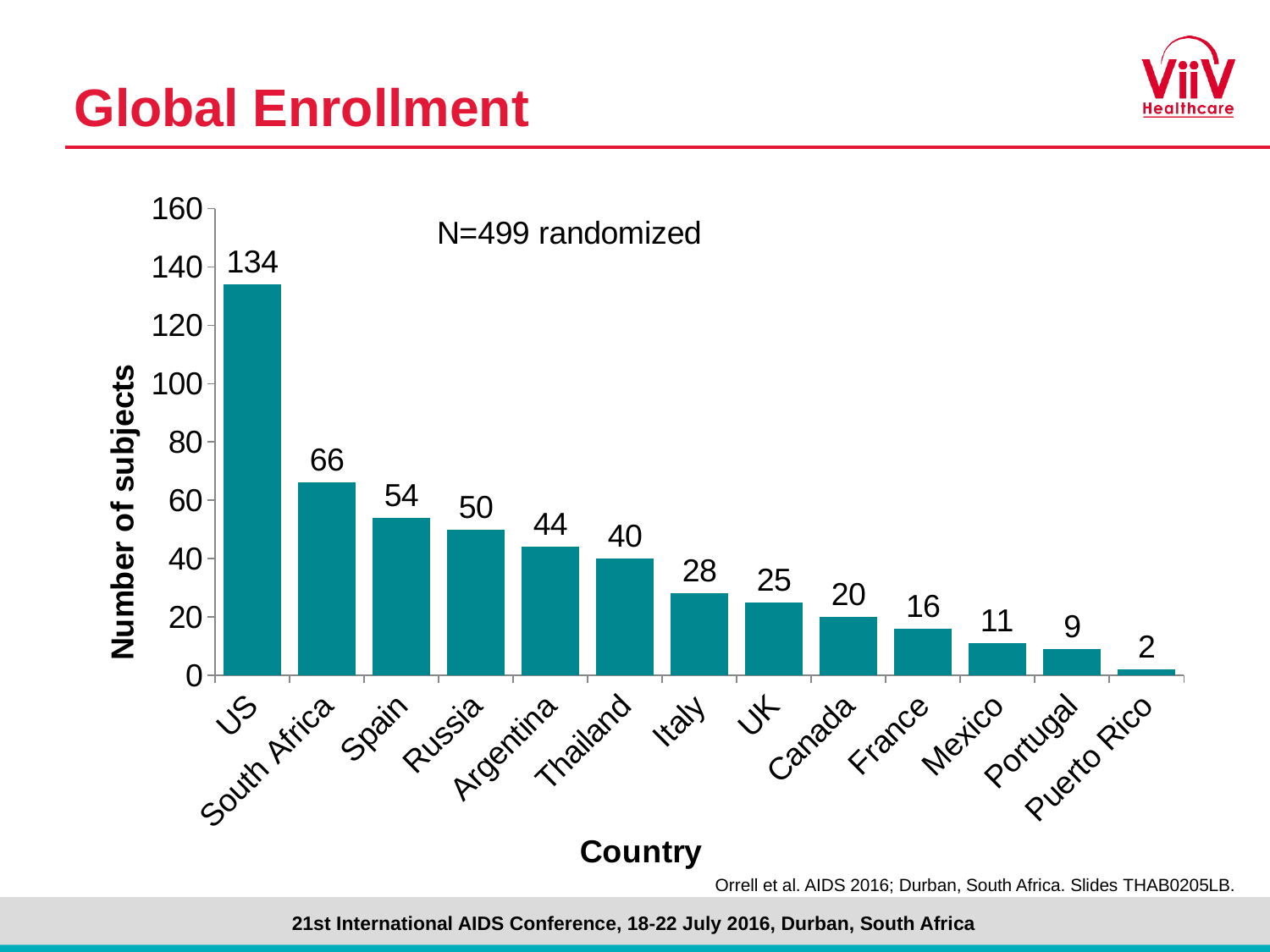
How many subjects were enrolled in the US? 134 How many subjects were enrolled in Mexico? 11 Is the value for Russia greater or less than 60? less What is the number of subjects for Thailand? 40 What is the label of the y axis? Number of subjects Do the values rise or fall from left to right along the x axis? fall Which country has the lowest number of subjects? Puerto Rico Which has more subjects, Italy or the UK? Italy What is the difference in number of subjects between South Africa and Spain? 12 What kind of chart is shown on the slide? bar chart How many countries are shown on the x axis? 13 Which country has the highest number of subjects? US